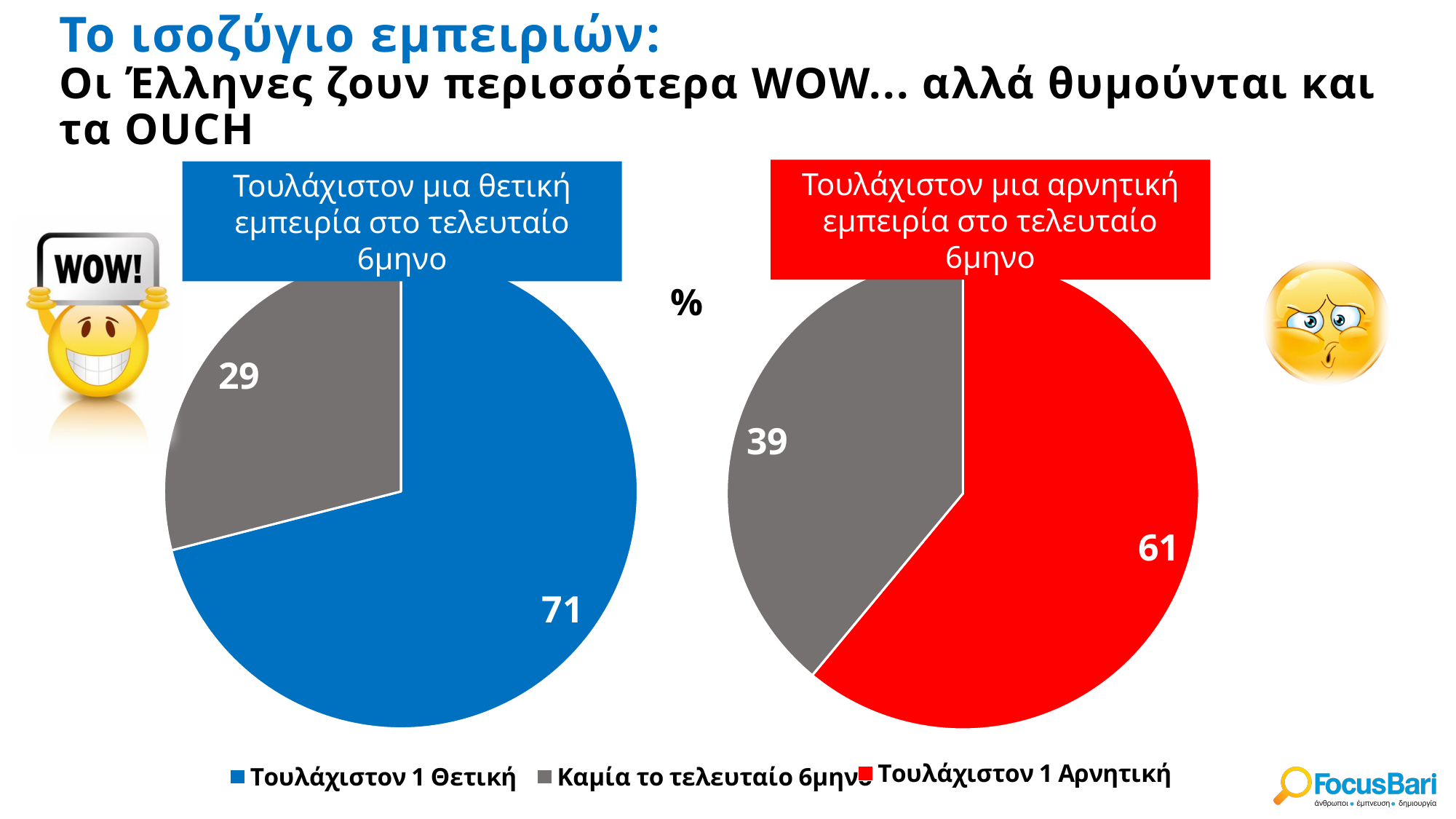
In the right pie chart, what is the difference between the red slice (61) and the grey slice (39)? 22 In the left pie chart (Τουλάχιστον μια θετική εμπειρία στο τελευταίο 6μηνο), what value is shown for the grey slice (Καμία το τελευταίο 6μηνο)? 29 How many slices does each pie chart on the slide have? 2 In the left pie chart (Τουλάχιστον μια θετική εμπειρία στο τελευταίο 6μηνο), what value is shown for the blue slice (Τουλάχιστον 1 Θετική)? 71 In the left pie chart, what is the difference between the blue slice (71) and the grey slice (29)? 42 In the right pie chart, which slice is the smallest? Καμία το τελευταίο 6μηνο In the left pie chart, which slice is the largest? Τουλάχιστον 1 Θετική In the right pie chart (Τουλάχιστον μια αρνητική εμπειρία στο τελευταίο 6μηνο), what value is shown for the grey slice (Καμία το τελευταίο 6μηνο)? 39 In the right pie chart (Τουλάχιστον μια αρνητική εμπειρία στο τελευταίο 6μηνο), what value is shown for the red slice (Τουλάχιστον 1 Αρνητική)? 61 How many entries does the legend at the bottom of the slide list? 3 Which is larger: the blue slice in the left pie chart or the red slice in the right pie chart? The blue slice in the left pie chart (71) What type of chart is used on the slide? Pie chart